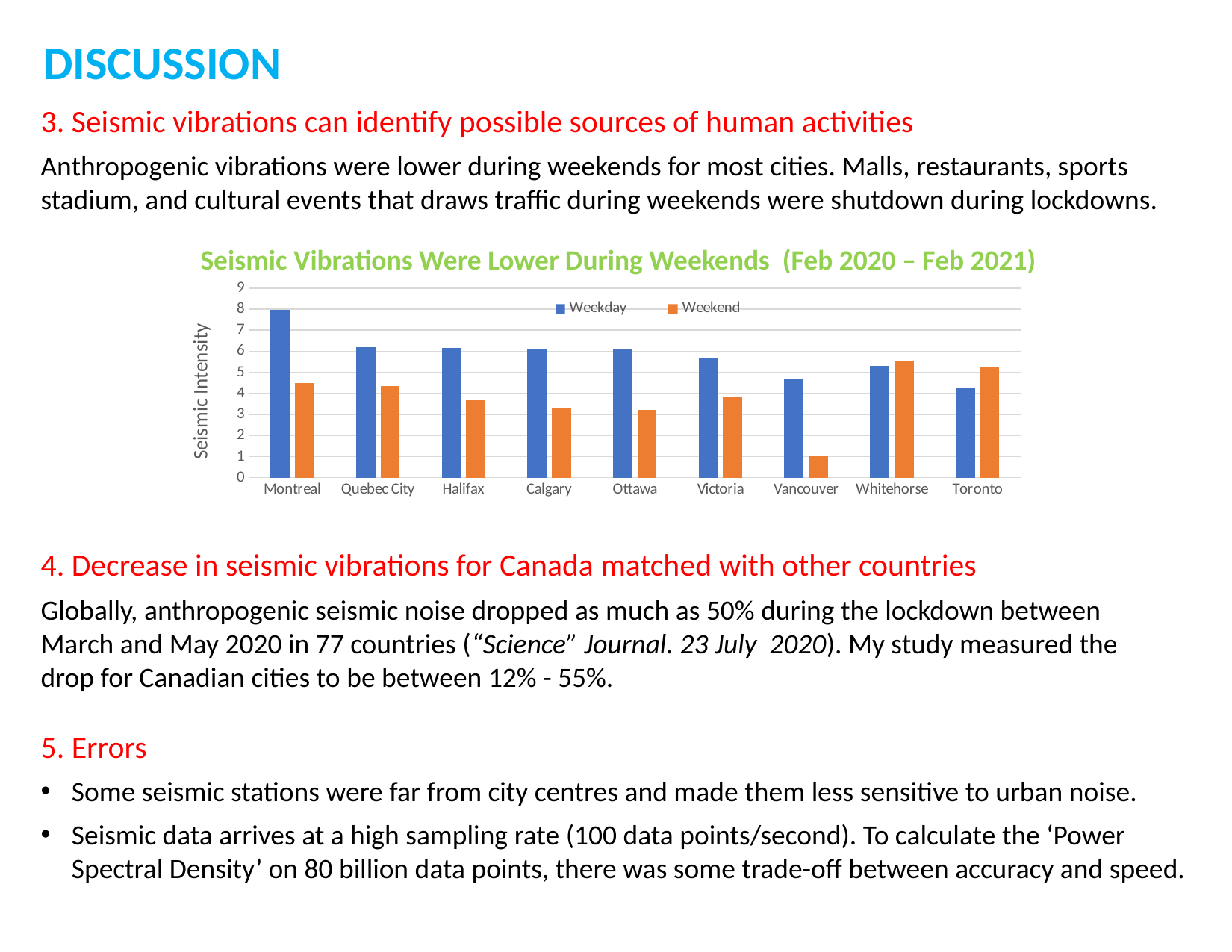
Which city has the highest Weekday seismic intensity? Montreal Is the Weekend value for Vancouver greater or less than 2? less Which city has the lowest Weekday seismic intensity? Toronto Is the Weekday value for Montreal greater or less than 7? greater For Toronto, which is larger, the Weekday or the Weekend value? Weekend What is the label on the chart's y axis? Seismic Intensity How many series does the chart's legend list? 2 For Montreal, which is larger, the Weekday or the Weekend value? Weekday Is the Weekday value for Toronto greater or less than 5? less What kind of chart is shown on the slide? Bar chart How many cities are shown on the x axis of the chart? 9 Which city has the lowest Weekend seismic intensity? Vancouver